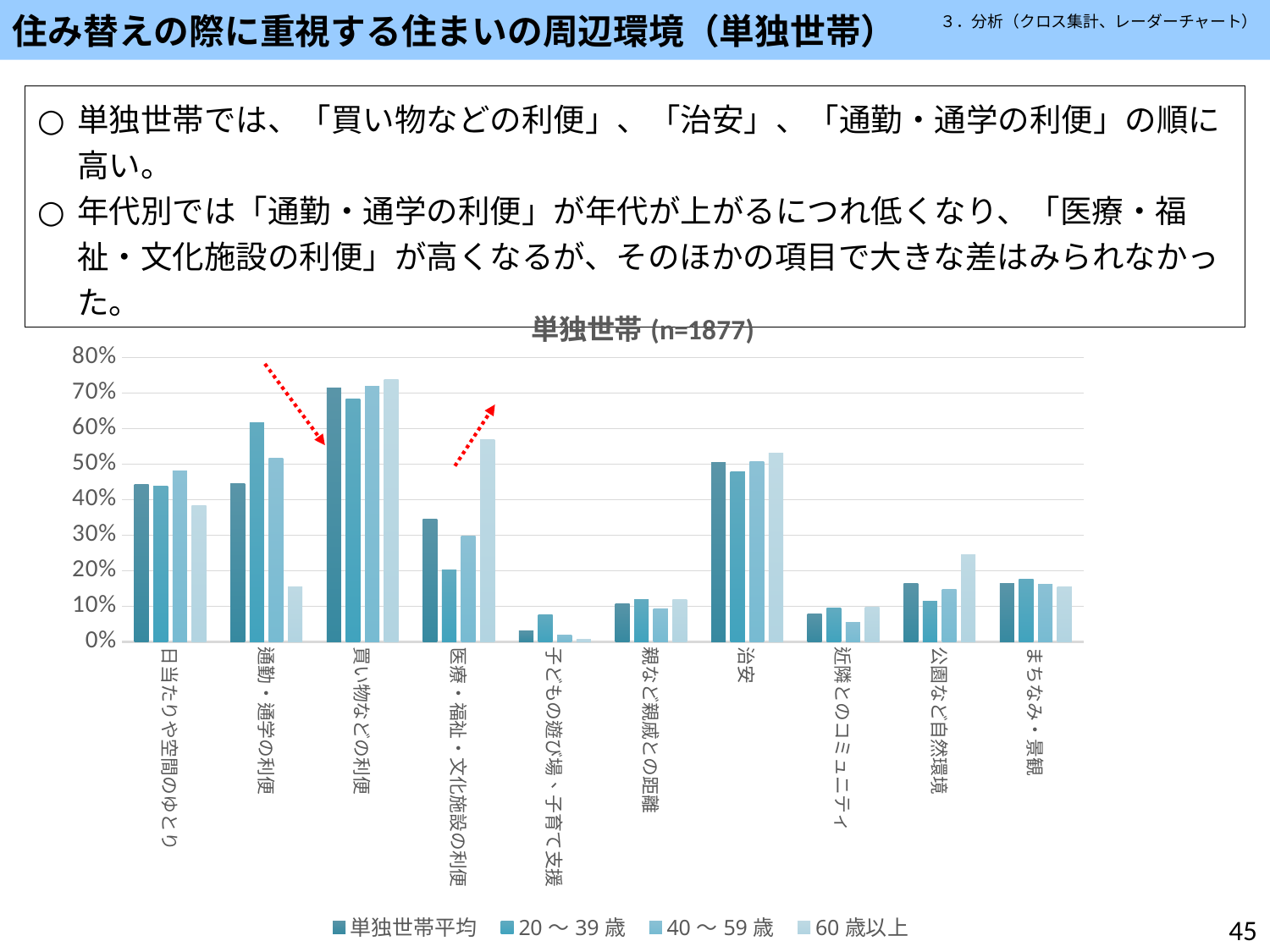
For 公園など自然環境, which series has the larger value: 20～39歳 or 60歳以上? 60歳以上 For 通勤・通学の利便, do the values rise or fall going from the 20～39歳 series to the 60歳以上 series? fall Is the value for 通勤・通学の利便 in the 60歳以上 series greater or less than 20%? less How many categories are shown on the x axis of the chart? 10 How many series does the chart's legend list? 4 Which category has the lowest value for the 単独世帯平均 series? 子どもの遊び場、子育て支援 Is the value for 買い物などの利便 in the 60歳以上 series greater or less than 70%? greater Is the value for 治安 in the 単独世帯平均 series greater or less than 40%? greater Which category has the highest value for the 単独世帯平均 series? 買い物などの利便 For 医療・福祉・文化施設の利便, which series has the larger value: 20～39歳 or 60歳以上? 60歳以上 What is the title of the chart? 単独世帯 (n=1877) What kind of chart is shown on the slide? bar chart